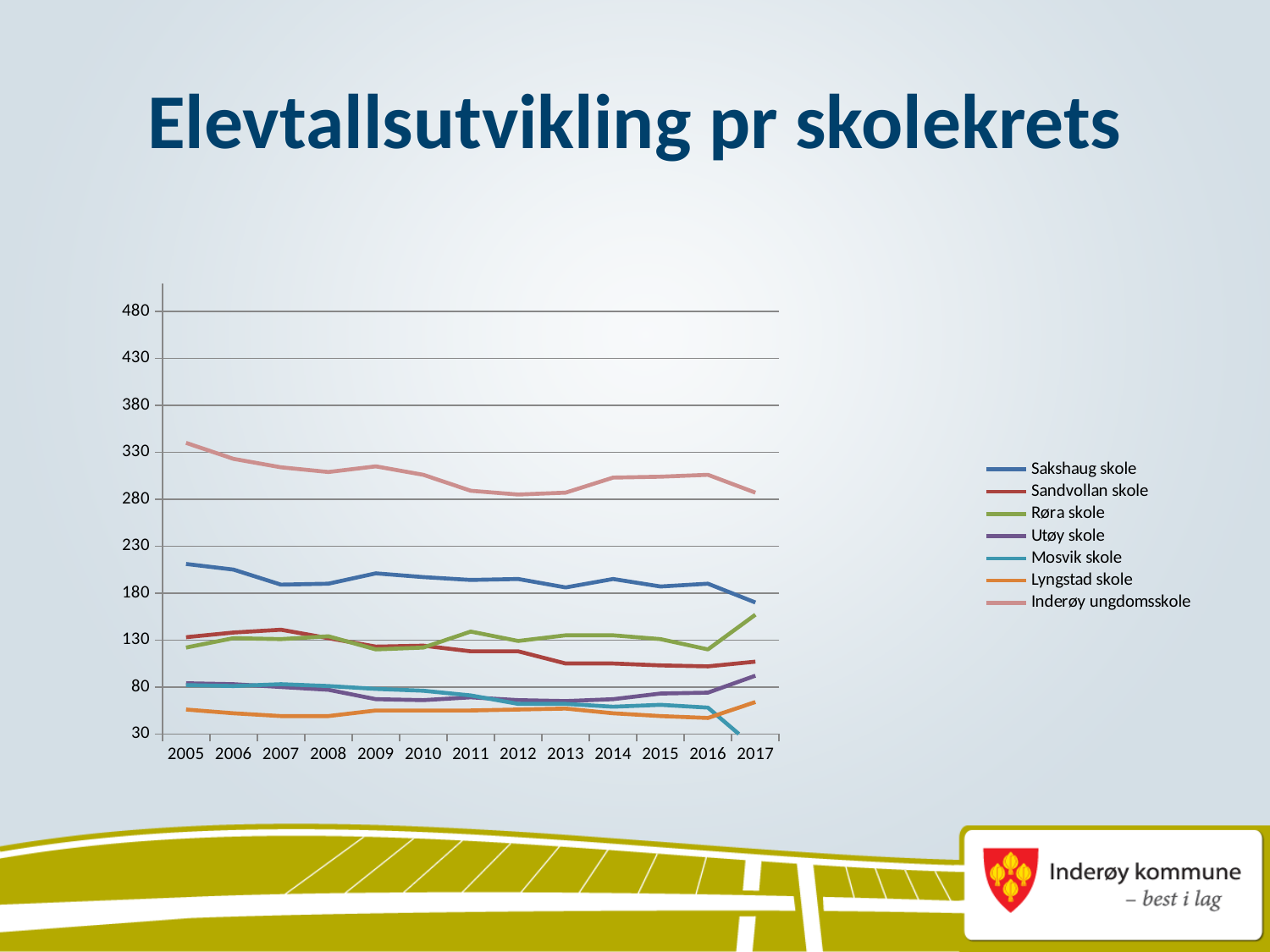
How many series does the legend list? 7 Is the value for Røra skole in 2017 greater or less than 130? greater Does the value for Sakshaug skole rise or fall from 2005 to 2017? fall In 2017, which is larger: Røra skole or Sandvollan skole? Røra skole Which school has the highest number of pupils across the whole period? Inderøy ungdomsskole What kind of chart is shown on the slide? Line chart Is the value for Inderøy ungdomsskole in 2017 greater or less than 280? greater Is the value for Sakshaug skole in 2005 greater or less than 180? greater Which school has the lowest value in 2017? Mosvik skole How many years are shown along the x axis? 13 What is the title of the slide? Elevtallsutvikling pr skolekrets